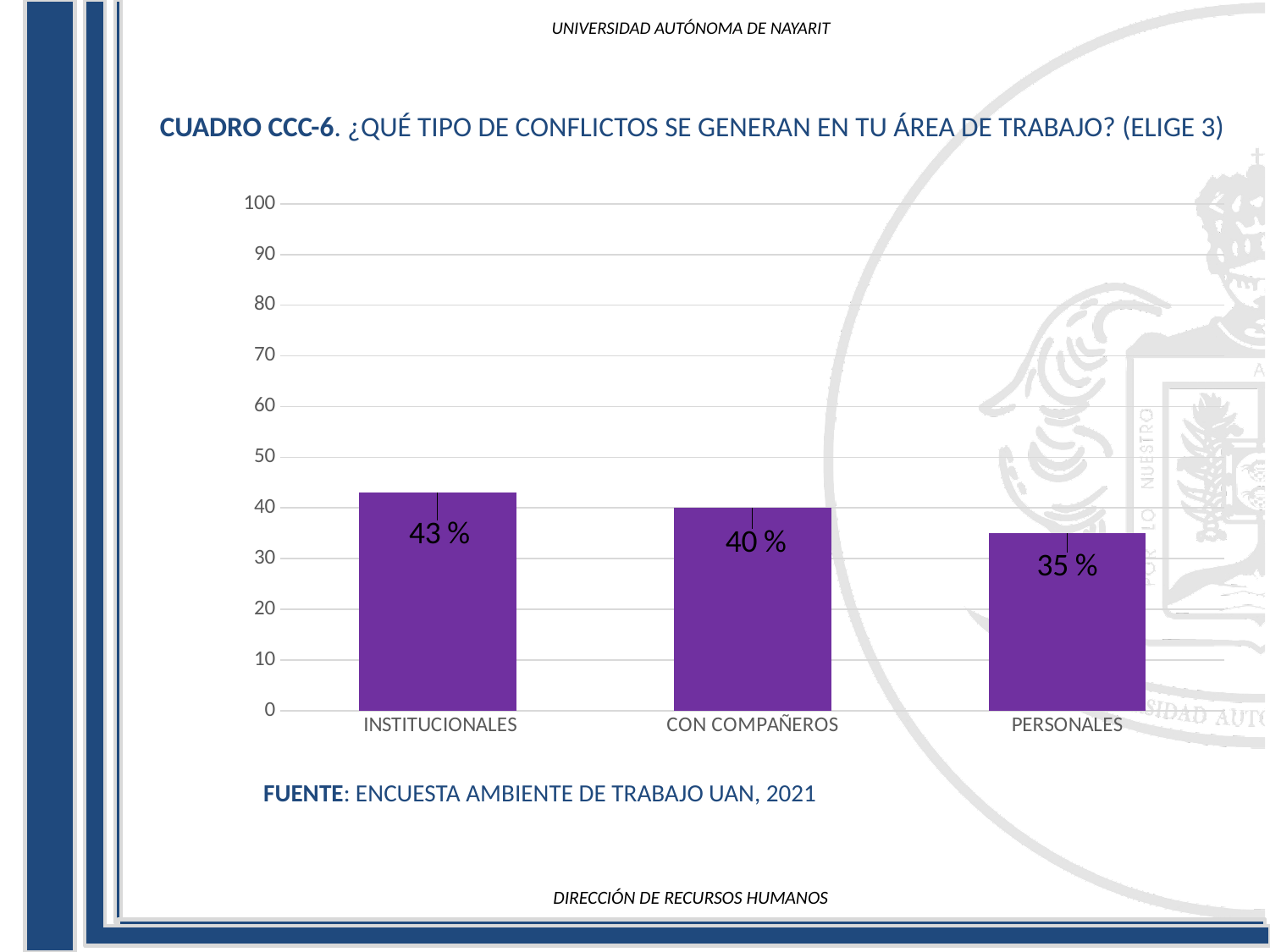
What is the value for PERSONALES? 35 % Which category has the highest value? INSTITUCIONALES What is the value for INSTITUCIONALES? 43 % What is the difference between the values for CON COMPAÑEROS and PERSONALES? 5 % Which is larger, the value for INSTITUCIONALES or the value for CON COMPAÑEROS? INSTITUCIONALES Do the values rise or fall from left to right along the x axis? fall Is the value for PERSONALES greater or less than 40? less What is the difference between the values for INSTITUCIONALES and PERSONALES? 8 % Which category has the lowest value? PERSONALES What kind of chart is shown on the slide? bar chart How many categories are shown in the chart? 3 What is the value for CON COMPAÑEROS? 40 %